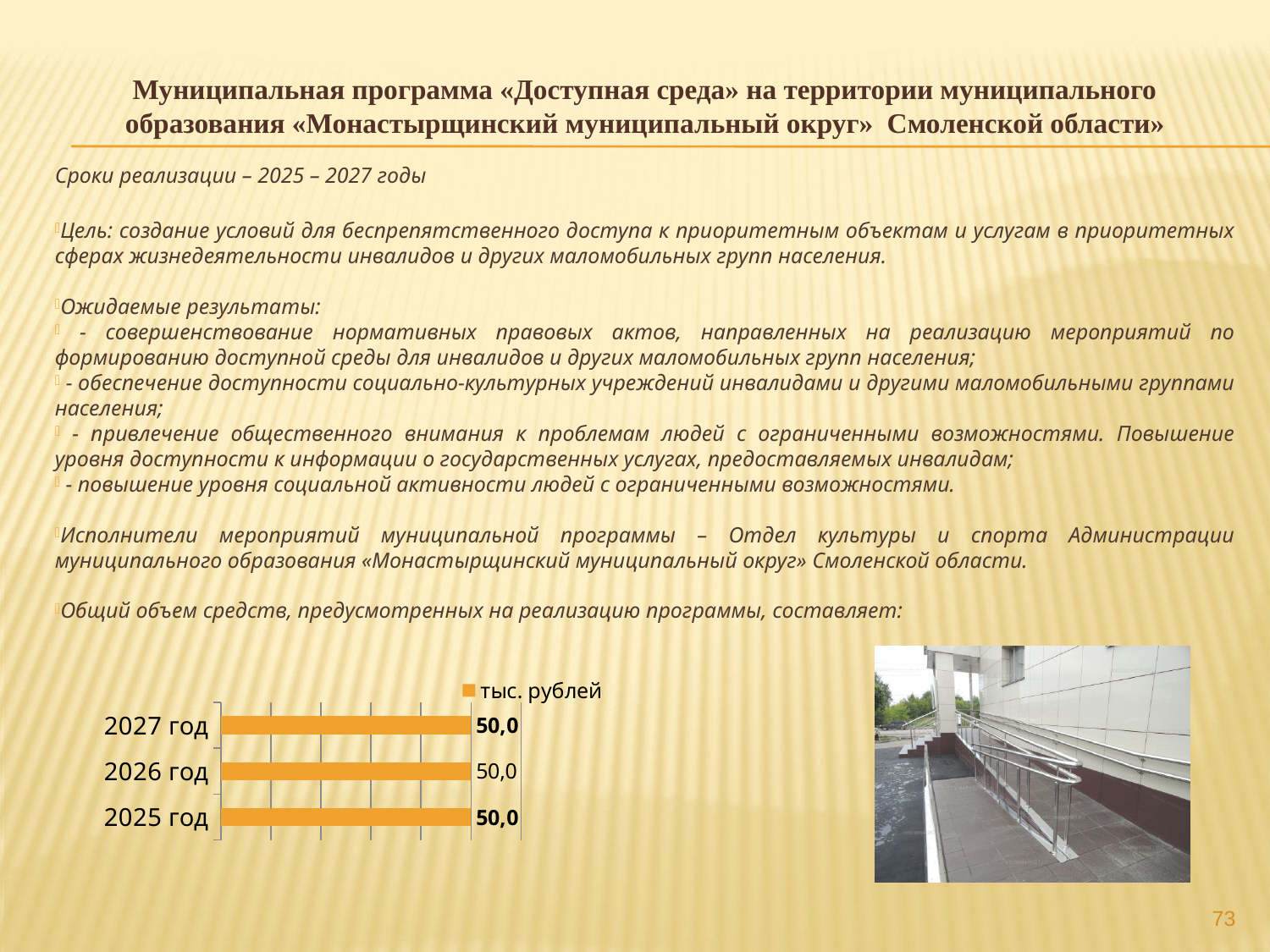
What is the name of the series in the chart legend? тыс. рублей Do the values change from 2025 год to 2027 год? No, they stay the same What colour are the bars in the chart? Orange What is the value for 2025 год in the chart? 50,0 How many categories (years) are shown in the chart? 3 How many series does the chart legend list? 1 What kind of chart is shown on the slide? Bar chart What is the value for 2026 год in the chart? 50,0 What is the difference between the values for 2027 год and 2025 год? 0,0 What is the value for 2027 год in the chart? 50,0